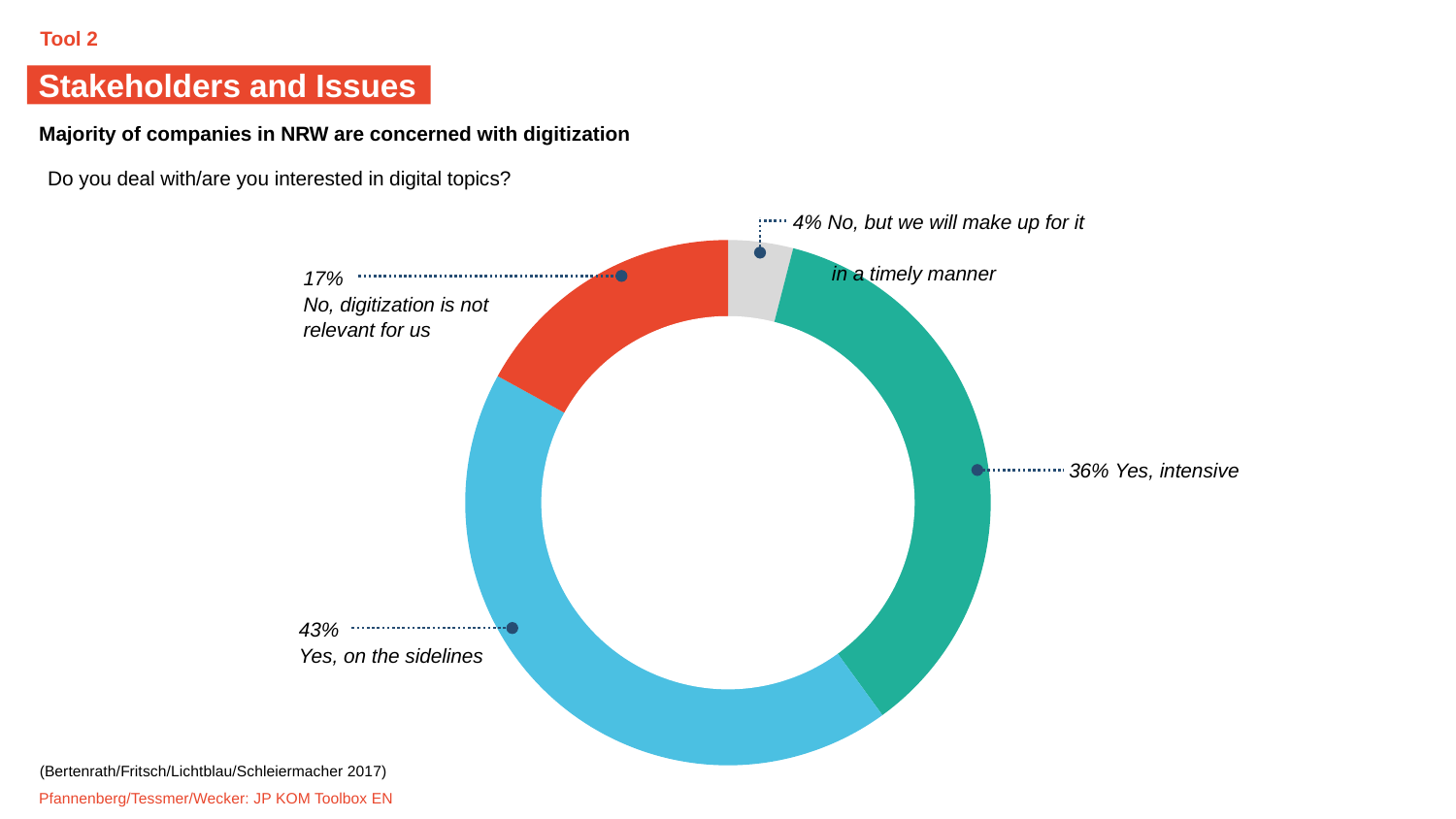
What survey question does the chart answer? Do you deal with/are you interested in digital topics? What percentage of companies answered "Yes, on the sidelines"? 43% What percentage of companies answered "Yes, intensive"? 36% What colour is the segment for "Yes, intensive"? Green What percentage of companies answered "No, but we will make up for it in a timely manner"? 4% Which response has the largest share of the chart? Yes, on the sidelines How many response categories are shown in the chart? 4 Which response has the smallest share of the chart? No, but we will make up for it in a timely manner What percentage of companies answered "No, digitization is not relevant for us"? 17% What kind of chart is shown on the slide? Doughnut chart What is the difference in percentage points between "Yes, on the sidelines" and "Yes, intensive"? 7 Which is larger: the share for "No, digitization is not relevant for us" or the share for "No, but we will make up for it in a timely manner"? No, digitization is not relevant for us